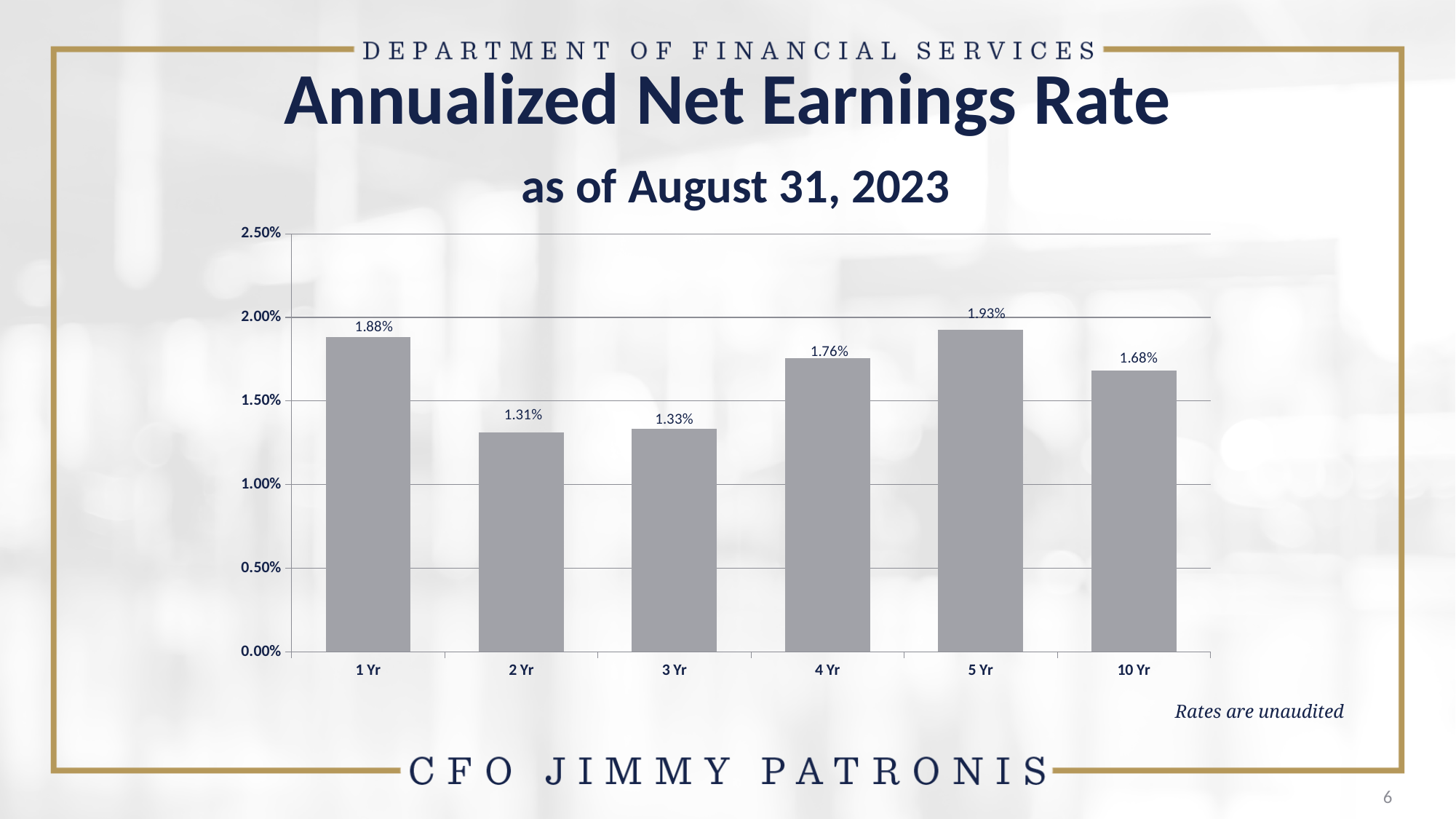
What is the annualized net earnings rate for 4 Yr? 1.76% What is the difference between the 1 Yr rate and the 10 Yr rate? 0.20% What is the annualized net earnings rate for 1 Yr? 1.88% What is the annualized net earnings rate for 10 Yr? 1.68% Which is larger, the 4 Yr rate or the 10 Yr rate? 4 Yr How many periods are shown on the x axis? 6 Is the value for 3 Yr greater or less than 1.50%? less What kind of chart is shown on the slide? bar chart Which period has the highest annualized net earnings rate? 5 Yr As of what date are the annualized net earnings rates reported? August 31, 2023 What is the difference between the 5 Yr rate and the 2 Yr rate? 0.62% Which period has the lowest annualized net earnings rate? 2 Yr